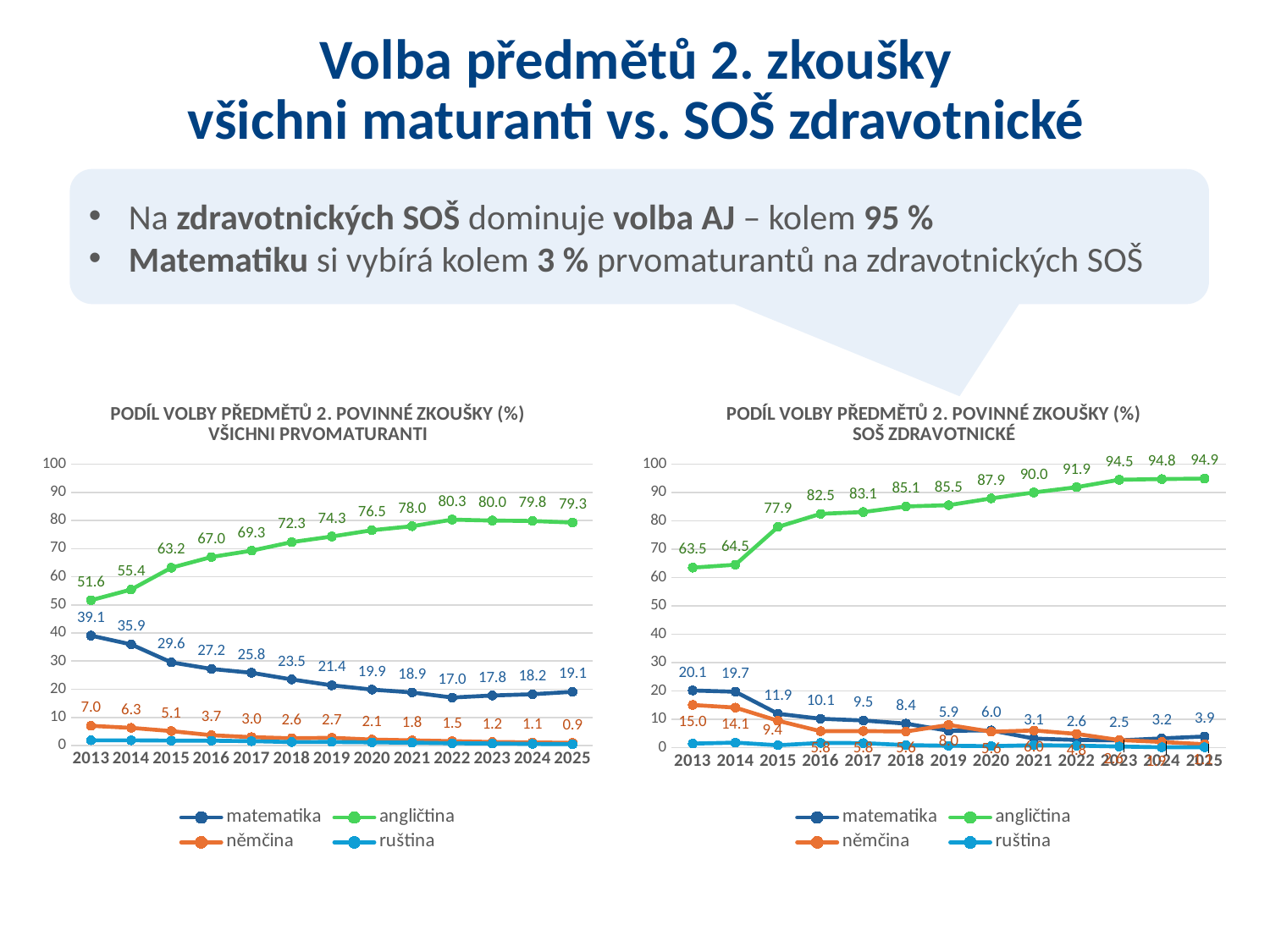
In the left chart (VŠICHNI PRVOMATURANTI), does the matematika series generally rise or fall from 2013 to 2022? fall How many series does the legend of the right chart (SOŠ ZDRAVOTNICKÉ) list? 4 In the right chart (SOŠ ZDRAVOTNICKÉ), what is the value for matematika in 2013? 20.1 In the left chart (VŠICHNI PRVOMATURANTI), what is the value for matematika in 2013? 39.1 In the right chart (SOŠ ZDRAVOTNICKÉ), what is the value for angličtina in 2025? 94.9 In the left chart (VŠICHNI PRVOMATURANTI), what is the value for němčina in 2018? 2.6 In the right chart (SOŠ ZDRAVOTNICKÉ), what is the value for němčina in 2014? 14.1 In the left chart (VŠICHNI PRVOMATURANTI), what is the difference between the angličtina and matematika values in 2013? 12.5 In the left chart (VŠICHNI PRVOMATURANTI), what is the value for angličtina in 2025? 79.3 In the right chart (SOŠ ZDRAVOTNICKÉ), what is the difference between the angličtina values in 2015 and 2014? 13.4 What type of chart is the left chart (VŠICHNI PRVOMATURANTI)? line chart In the left chart (VŠICHNI PRVOMATURANTI), in which year does angličtina reach its highest value? 2022